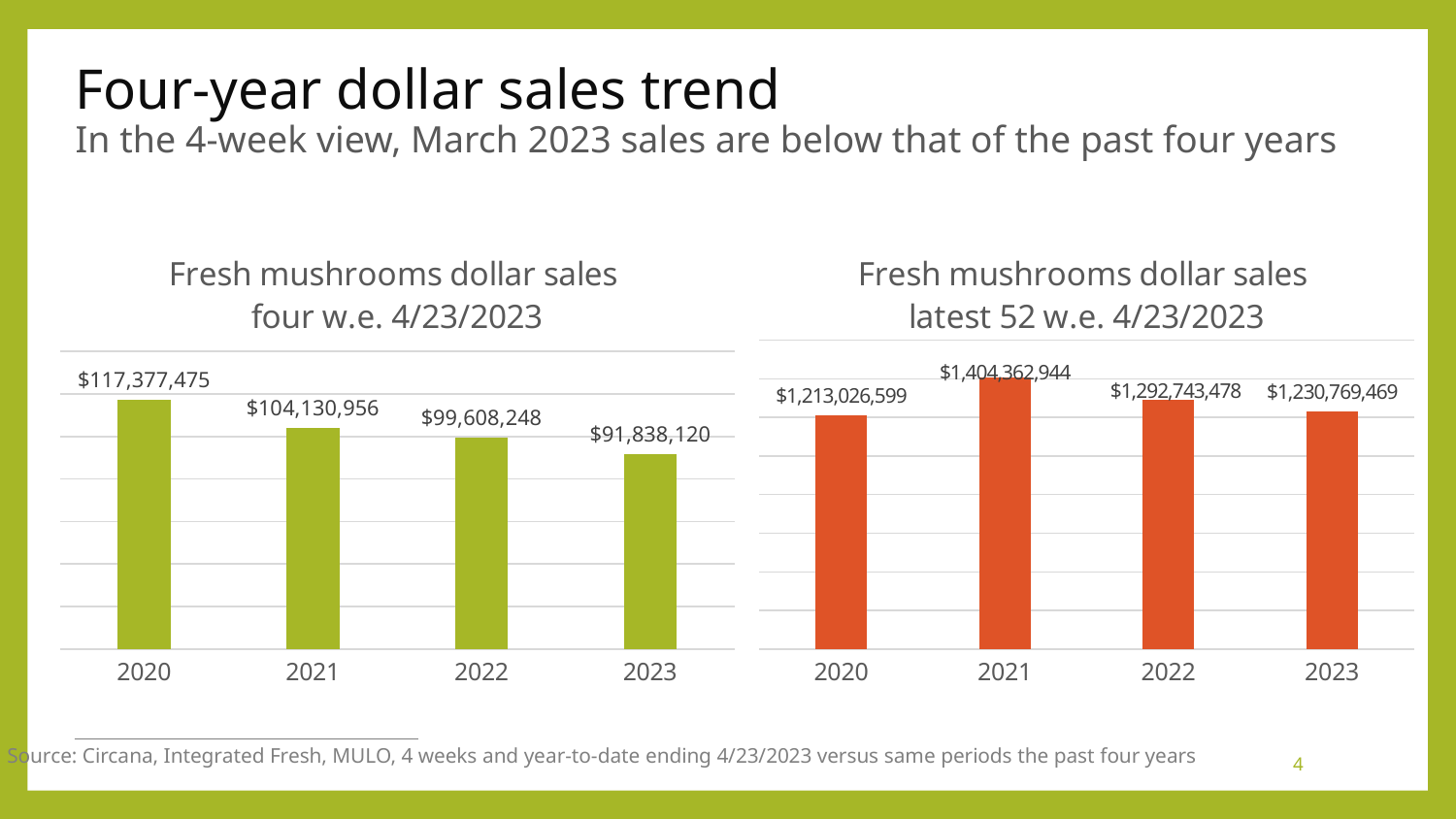
In the 'Fresh mushrooms dollar sales latest 52 w.e. 4/23/2023' chart, which is larger, the value for 2022 or the value for 2023? 2022 In the 'Fresh mushrooms dollar sales four w.e. 4/23/2023' chart, what is the difference between the 2020 and 2023 values? $25,539,355 In the 'Fresh mushrooms dollar sales latest 52 w.e. 4/23/2023' chart, what is the value for 2021? $1,404,362,944 In the 'Fresh mushrooms dollar sales latest 52 w.e. 4/23/2023' chart, which year has the highest value? 2021 In the 'Fresh mushrooms dollar sales latest 52 w.e. 4/23/2023' chart, what is the value for 2023? $1,230,769,469 In the 'Fresh mushrooms dollar sales four w.e. 4/23/2023' chart, what is the value for 2020? $117,377,475 In the 'Fresh mushrooms dollar sales four w.e. 4/23/2023' chart, which year has the lowest value? 2023 How many years are shown in the 'Fresh mushrooms dollar sales four w.e. 4/23/2023' chart? 4 In the 'Fresh mushrooms dollar sales four w.e. 4/23/2023' chart, what is the value for 2023? $91,838,120 In the 'Fresh mushrooms dollar sales latest 52 w.e. 4/23/2023' chart, what is the difference between the 2021 and 2020 values? $191,336,345 What kind of chart is the 'Fresh mushrooms dollar sales latest 52 w.e. 4/23/2023' chart? bar chart In the 'Fresh mushrooms dollar sales four w.e. 4/23/2023' chart, do the values rise or fall from 2020 to 2023? fall